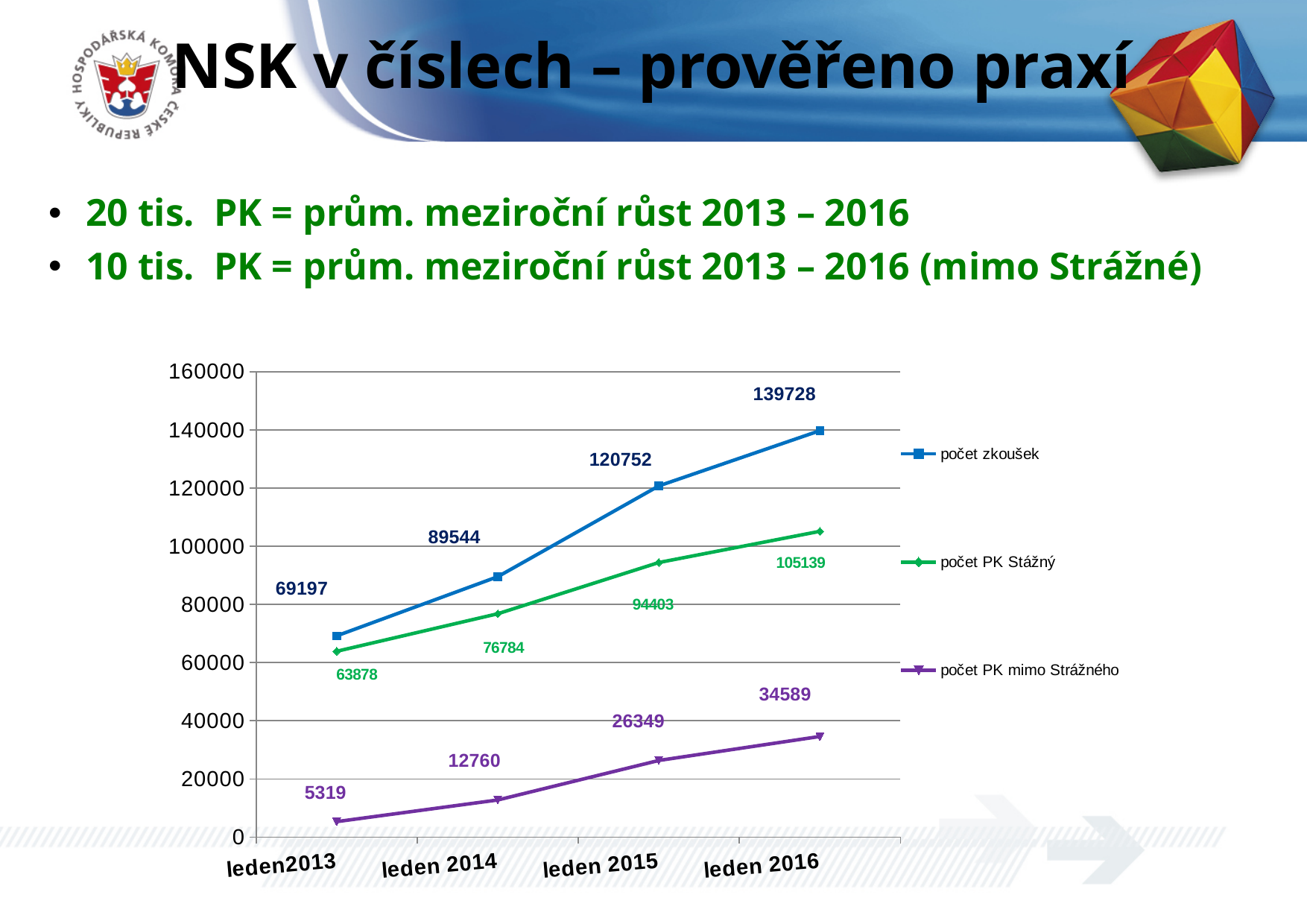
What type of chart is shown on the slide? line chart How many series does the chart legend list? 3 What is the difference between počet zkoušek and počet PK Stážný in leden 2016? 34589 Does počet PK mimo Strážného rise or fall from leden2013 to leden 2016? rise How many points are plotted along the x axis for each series? 4 What is the value of počet PK mimo Strážného for leden2013? 5319 Which series is drawn in purple in the chart? počet PK mimo Strážného What is the value of počet PK Stážný for leden 2014? 76784 At which x-axis point is počet PK mimo Strážného highest? leden 2016 Which is larger in leden 2015: počet zkoušek or počet PK Stážný? počet zkoušek What is the value of počet zkoušek for leden 2016? 139728 At which x-axis point is počet zkoušek lowest? leden2013